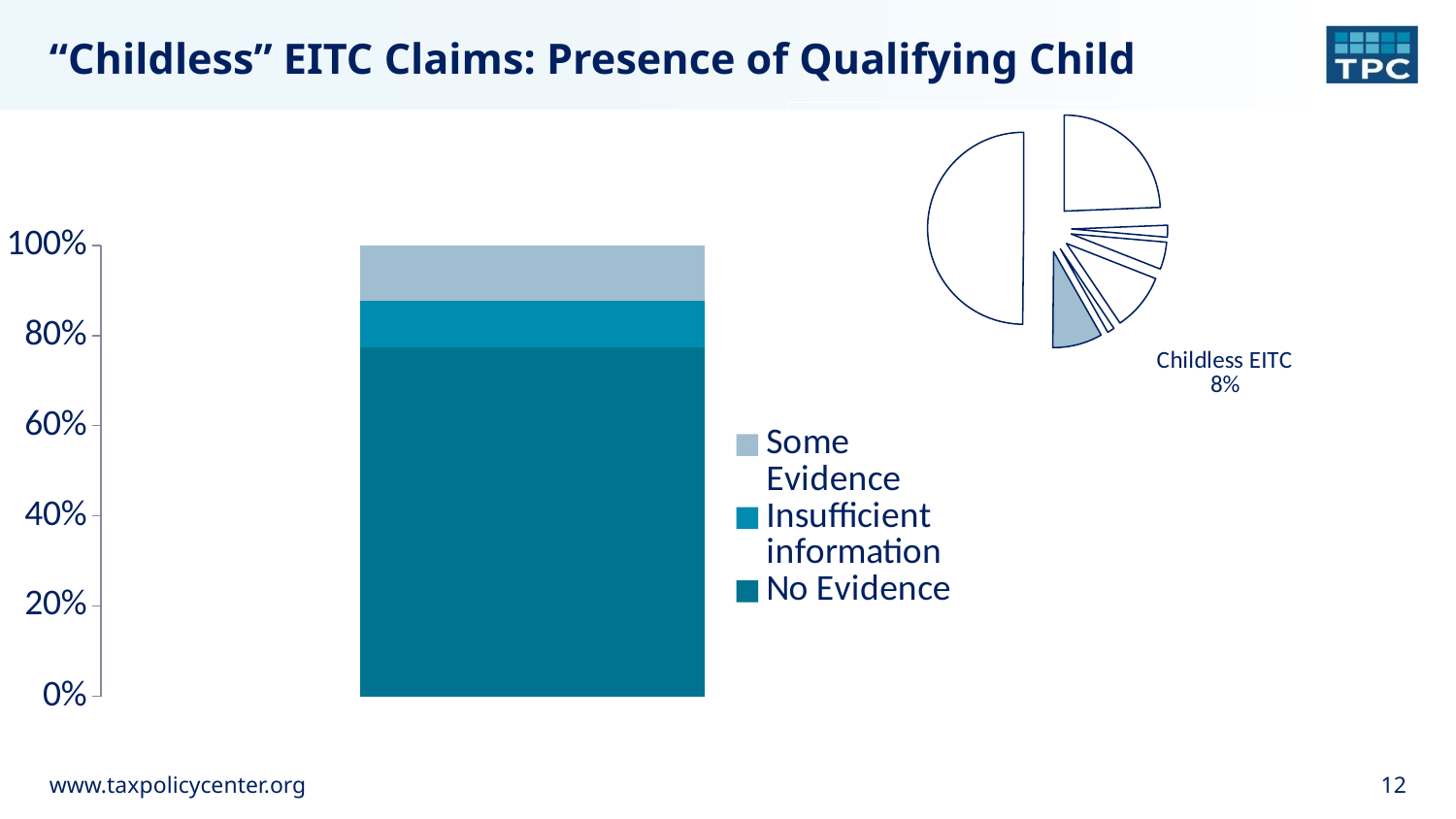
On the stacked bar chart on the left, which is larger: the No Evidence portion or the Some Evidence portion? No Evidence On the stacked bar chart on the left, is the value for No Evidence greater or less than 60%? greater On the stacked bar chart on the left, which legend entry is shown in the lightest colour? Some Evidence On the stacked bar chart on the left, which series takes up the largest portion of the bar? No Evidence What kind of chart is the chart in the upper right of the slide? pie chart On the stacked bar chart on the left, is the value for Some Evidence greater or less than 20%? less On the stacked bar chart on the left, how many series does the legend list? 3 On the stacked bar chart on the left, how many bars are plotted? 1 What is the title of the slide containing the charts? "Childless" EITC Claims: Presence of Qualifying Child On the stacked bar chart on the left, is the value for Insufficient information greater or less than 20%? less On the pie chart in the upper right, what share is labelled for the Childless EITC slice? 8% What kind of chart is the chart on the left of the slide? bar chart